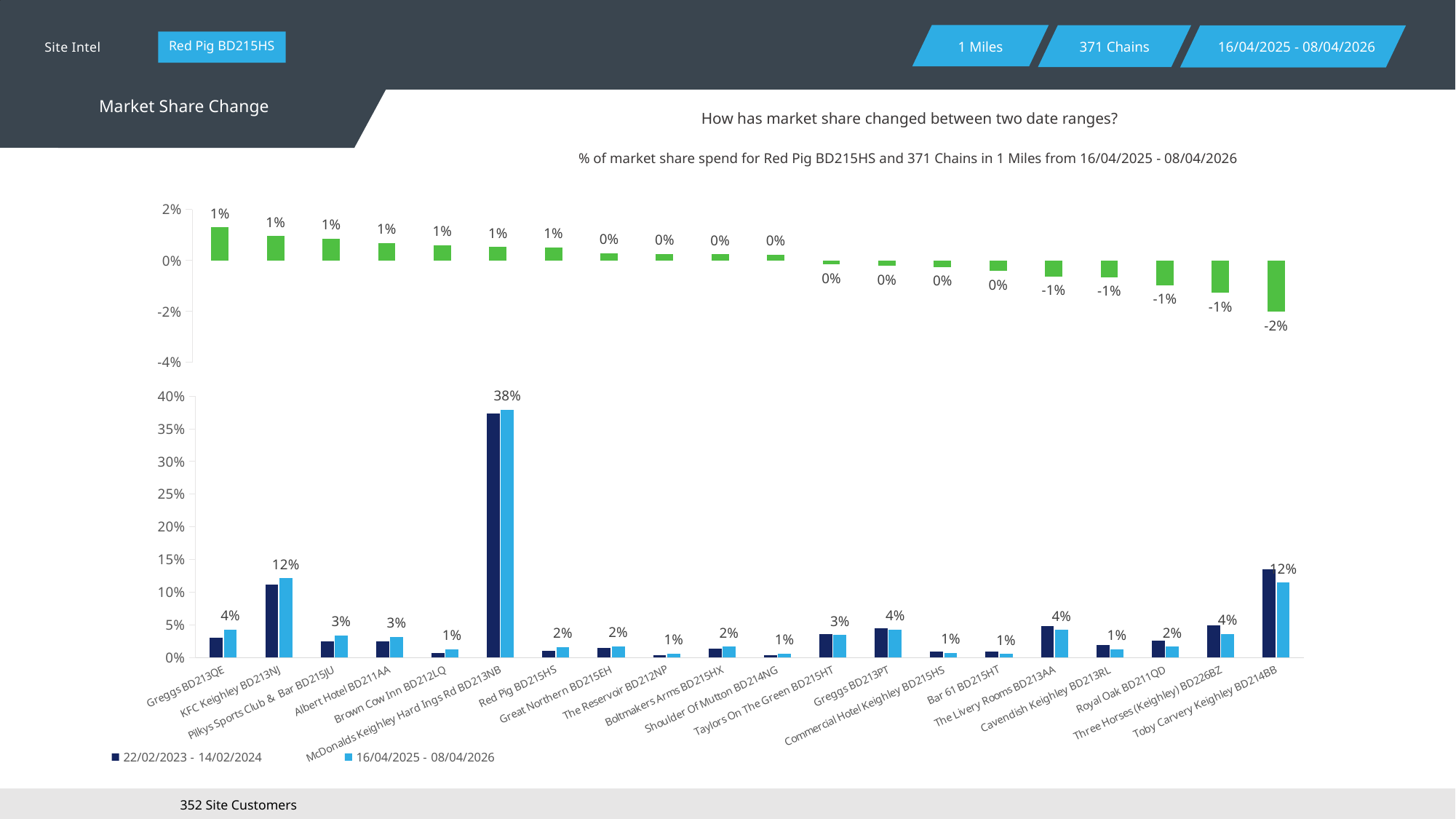
In the bottom chart, what data label is shown for McDonalds Keighley Hard Ings Rd BD213NB? 38% In the bottom chart, for Toby Carvery Keighley BD214BB, which series has the larger value: 22/02/2023 - 14/02/2024 or 16/04/2025 - 08/04/2026? 22/02/2023 - 14/02/2024 What are the two legend entries of the bottom chart? 22/02/2023 - 14/02/2024 and 16/04/2025 - 08/04/2026 What kind of chart is the bottom chart showing % of market share spend? bar chart In the bottom chart, what data label is shown for KFC Keighley BD213NJ? 12% How many series does the legend of the bottom chart list? 2 In the top chart of market share change, what is the lowest value labelled? -2% In the bottom chart, is the 22/02/2023 - 14/02/2024 value for McDonalds Keighley Hard Ings Rd BD213NB greater or less than 35%? greater In the bottom chart, for KFC Keighley BD213NJ, which series has the larger value: 22/02/2023 - 14/02/2024 or 16/04/2025 - 08/04/2026? 16/04/2025 - 08/04/2026 How many categories are shown on the x axis of the bottom chart? 20 In the bottom chart, which category has the highest market share? McDonalds Keighley Hard Ings Rd BD213NB In the top chart of market share change, do the values rise or fall from left to right? fall